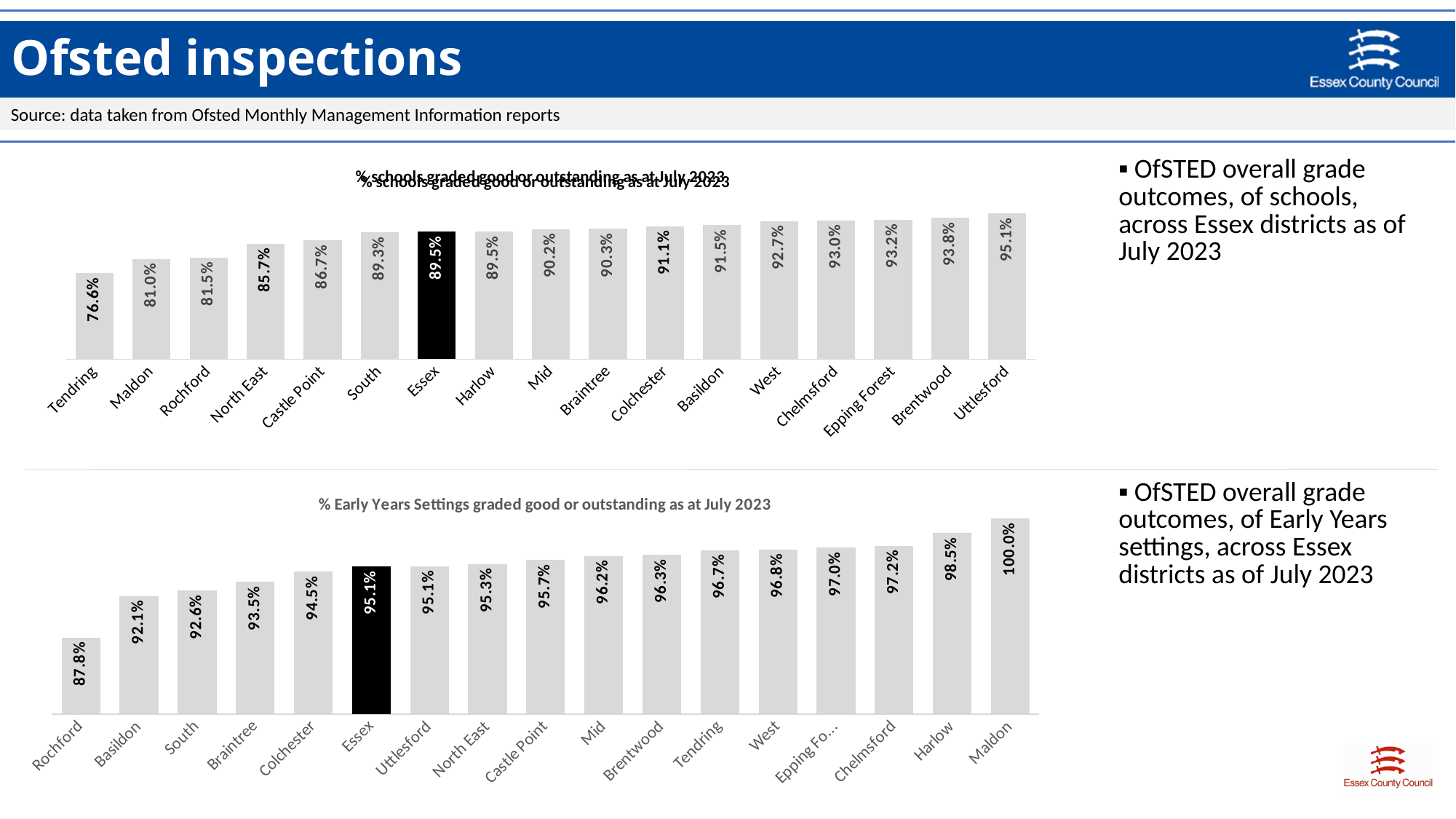
In the '% schools graded good or outstanding as at July 2023' chart, which district has the lowest value? Tendring In the '% Early Years Settings graded good or outstanding as at July 2023' chart, what is the value for Maldon? 100.0% In the '% schools graded good or outstanding as at July 2023' chart, what is the difference between Uttlesford and Tendring? 18.5% In the '% schools graded good or outstanding as at July 2023' chart, what is the value for Essex? 89.5% In the '% schools graded good or outstanding as at July 2023' chart, what is the value for Tendring? 76.6% In the '% schools graded good or outstanding as at July 2023' chart, how many bars are plotted? 17 In the '% Early Years Settings graded good or outstanding as at July 2023' chart, which is larger, Harlow or Chelmsford? Harlow In the '% Early Years Settings graded good or outstanding as at July 2023' chart, which district has the lowest value? Rochford In the '% Early Years Settings graded good or outstanding as at July 2023' chart, do the values rise or fall from left to right? rise In the '% Early Years Settings graded good or outstanding as at July 2023' chart, what is the value for Rochford? 87.8% In the '% schools graded good or outstanding as at July 2023' chart, which district has the highest value? Uttlesford What kind of chart is the bottom chart on the slide? bar chart